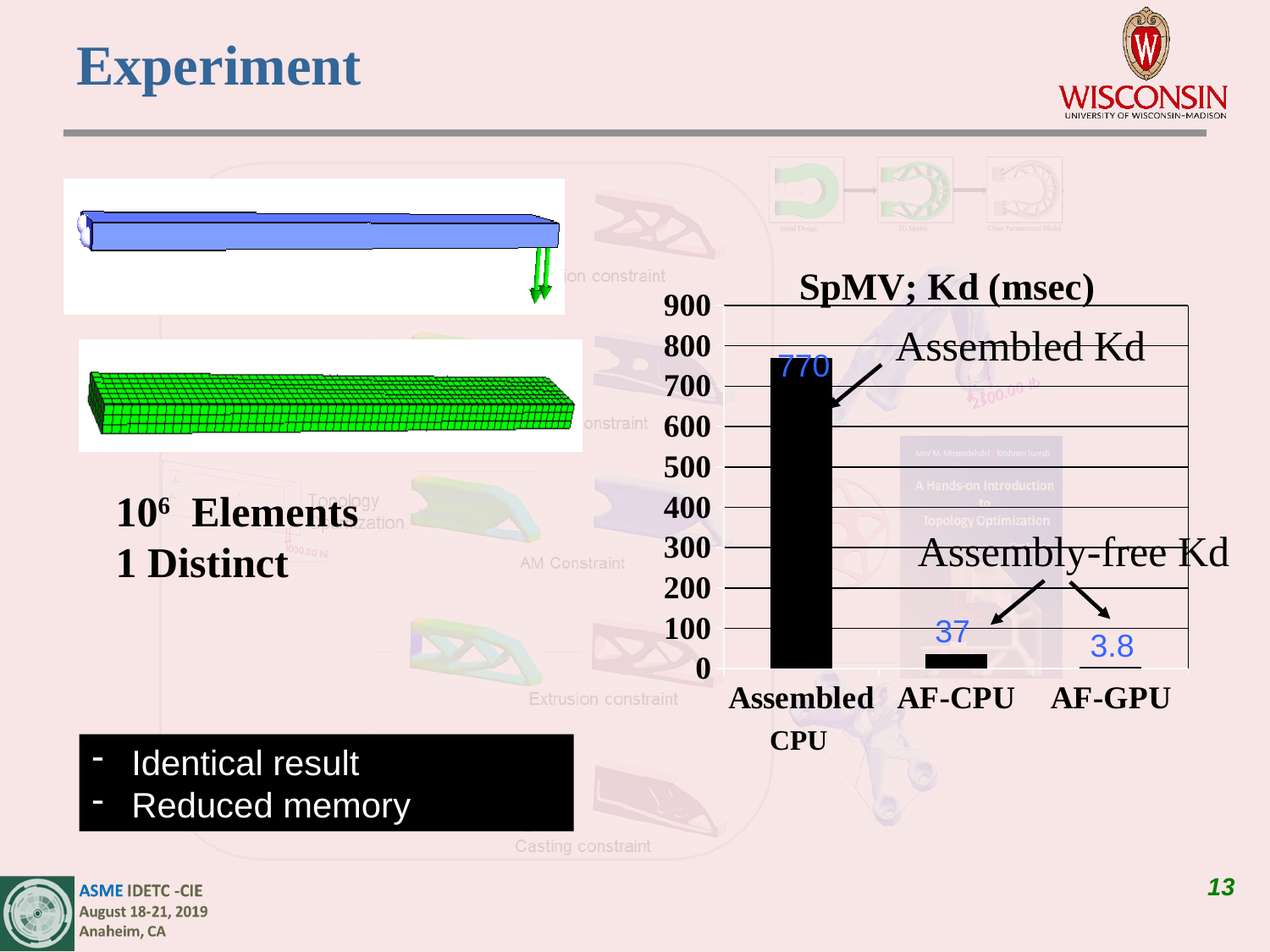
Is the value for Assembled CPU greater or less than 700? greater How many categories are shown on the x axis? 3 Which category has the lowest value? AF-GPU What is the value for Assembled CPU? 770 Which category has the highest value? Assembled CPU What is the value for AF-GPU? 3.8 What is the difference between the AF-CPU and AF-GPU values? 33.2 What is the difference between the Assembled CPU and AF-CPU values? 733 Which is larger, the value for AF-CPU or AF-GPU? AF-CPU What is the title of the chart? SpMV; Kd (msec) What kind of chart is shown? bar chart What is the value for AF-CPU? 37